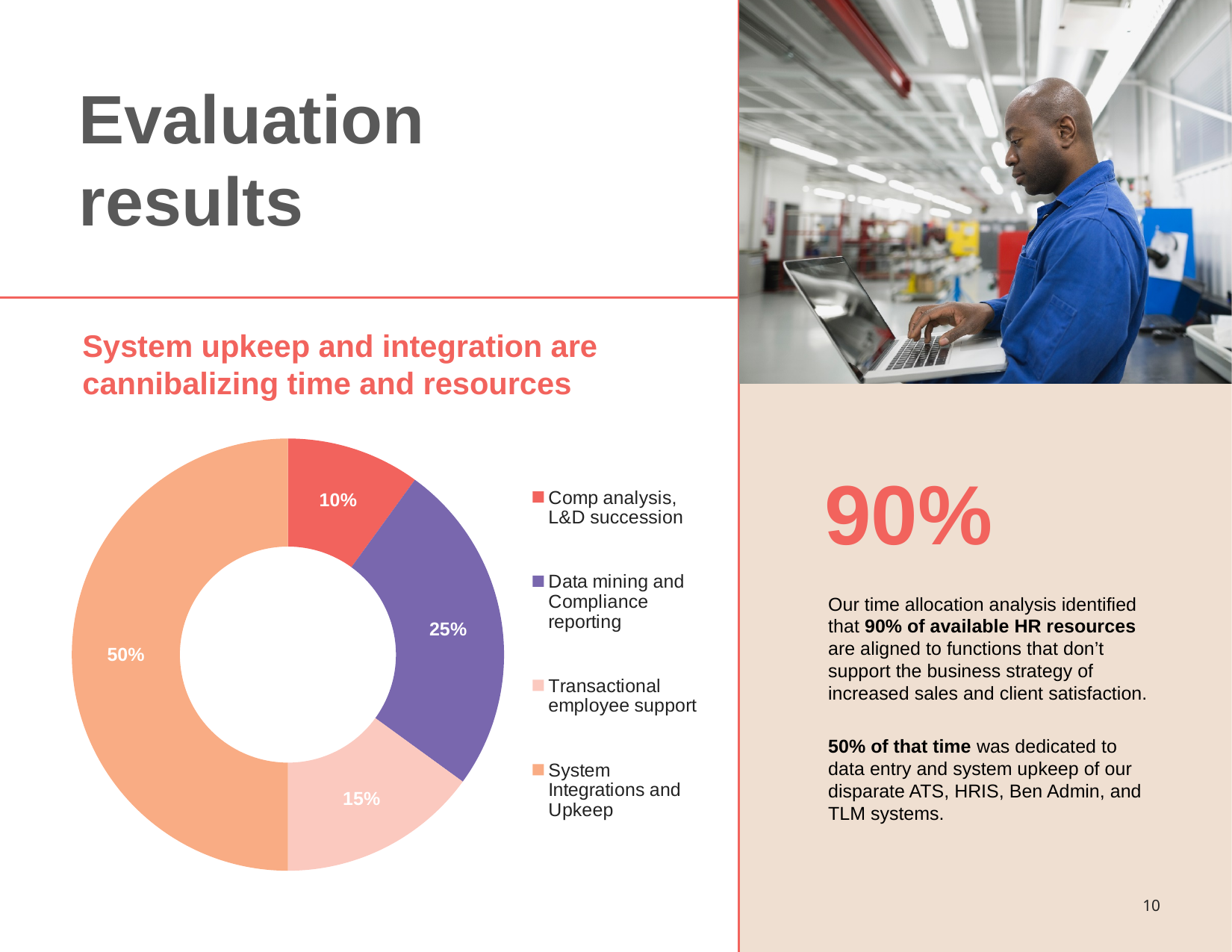
Which legend entry is shown in purple? Data mining and Compliance reporting What is the difference between the System Integrations and Upkeep slice and the Data mining and Compliance reporting slice? 25% Which category has the largest slice in the pie chart? System Integrations and Upkeep What value is shown for Transactional employee support in the pie chart? 15% Which category has the smallest slice in the pie chart? Comp analysis, L&D succession How many categories does the pie chart show? 4 What is the combined share of Transactional employee support and Comp analysis, L&D succession? 25% What share of the pie chart is labelled for System Integrations and Upkeep? 50% What kind of chart is shown on the slide? Doughnut chart Which is larger in the pie chart: Transactional employee support or Data mining and Compliance reporting? Data mining and Compliance reporting What value is shown for Comp analysis, L&D succession in the pie chart? 10% What value is shown for Data mining and Compliance reporting in the pie chart? 25%